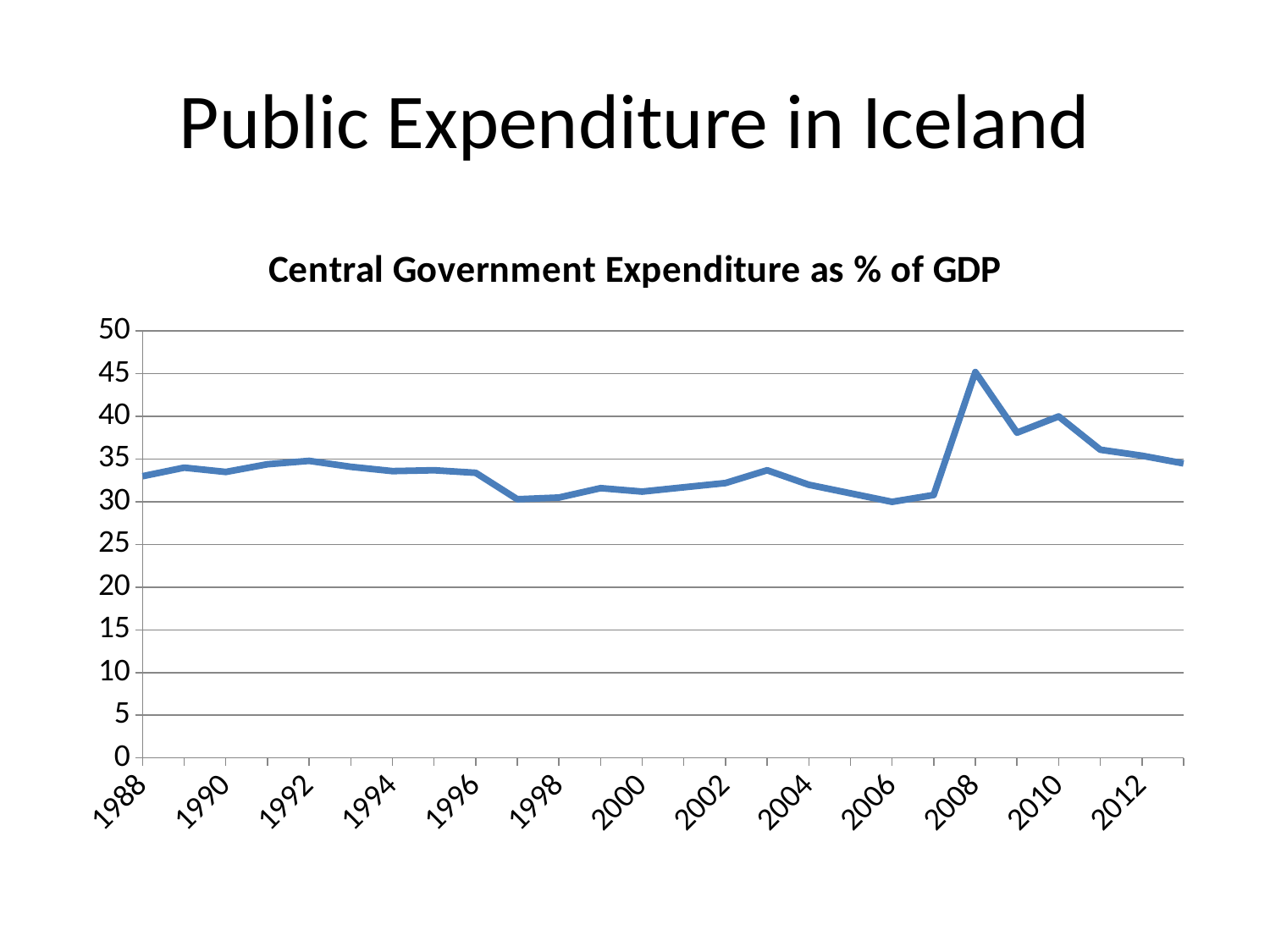
Which year has the larger value, 2006 or 2008? 2008 Is the value for 2006 greater or less than 35? less Is the value for 1992 greater or less than 40? less Is the value for 1998 greater or less than 25? greater What is the title of the chart? Central Government Expenditure as % of GDP Do the values rise or fall between 2008 and 2012? fall Which year has the larger value, 2000 or 2010? 2010 What kind of chart is shown on the slide? line chart How many year labels are shown on the x axis? 13 In which year does the line reach its highest value? 2008